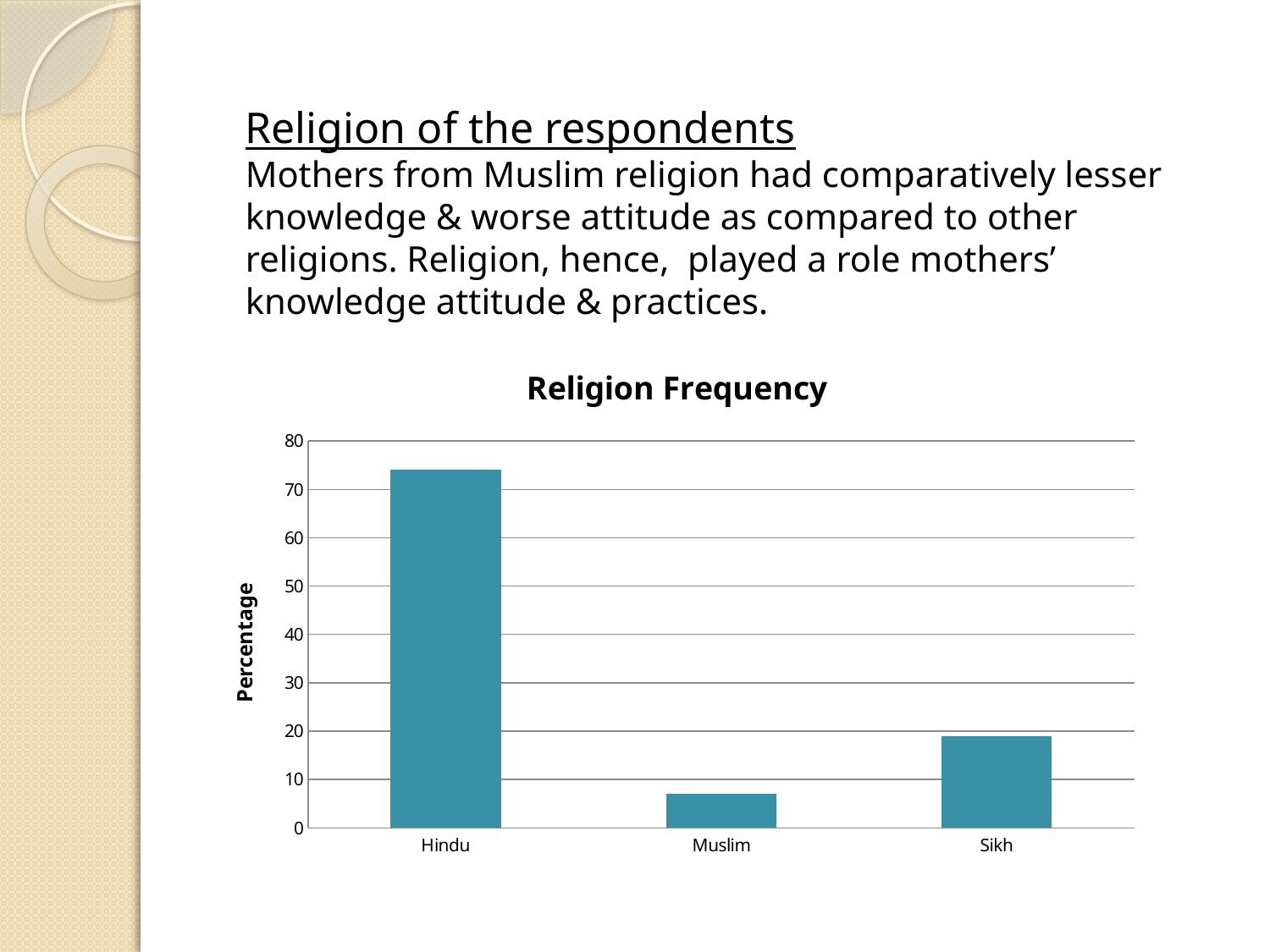
What is the title of the chart on the slide? Religion Frequency What is the label on the vertical axis of the Religion Frequency chart? Percentage Is the value for Sikh greater or less than 10? greater What kind of chart is shown under the title "Religion Frequency"? bar chart Which religion has the lowest percentage in the Religion Frequency chart? Muslim Is the value for Muslim greater or less than 10? less Which religion has the highest percentage in the Religion Frequency chart? Hindu How many religion categories are plotted in the Religion Frequency chart? 3 In the Religion Frequency chart, which is larger, the percentage for Sikh or for Muslim? Sikh Is the value for Hindu greater or less than 70? greater In the Religion Frequency chart, which is larger, the percentage for Hindu or for Sikh? Hindu